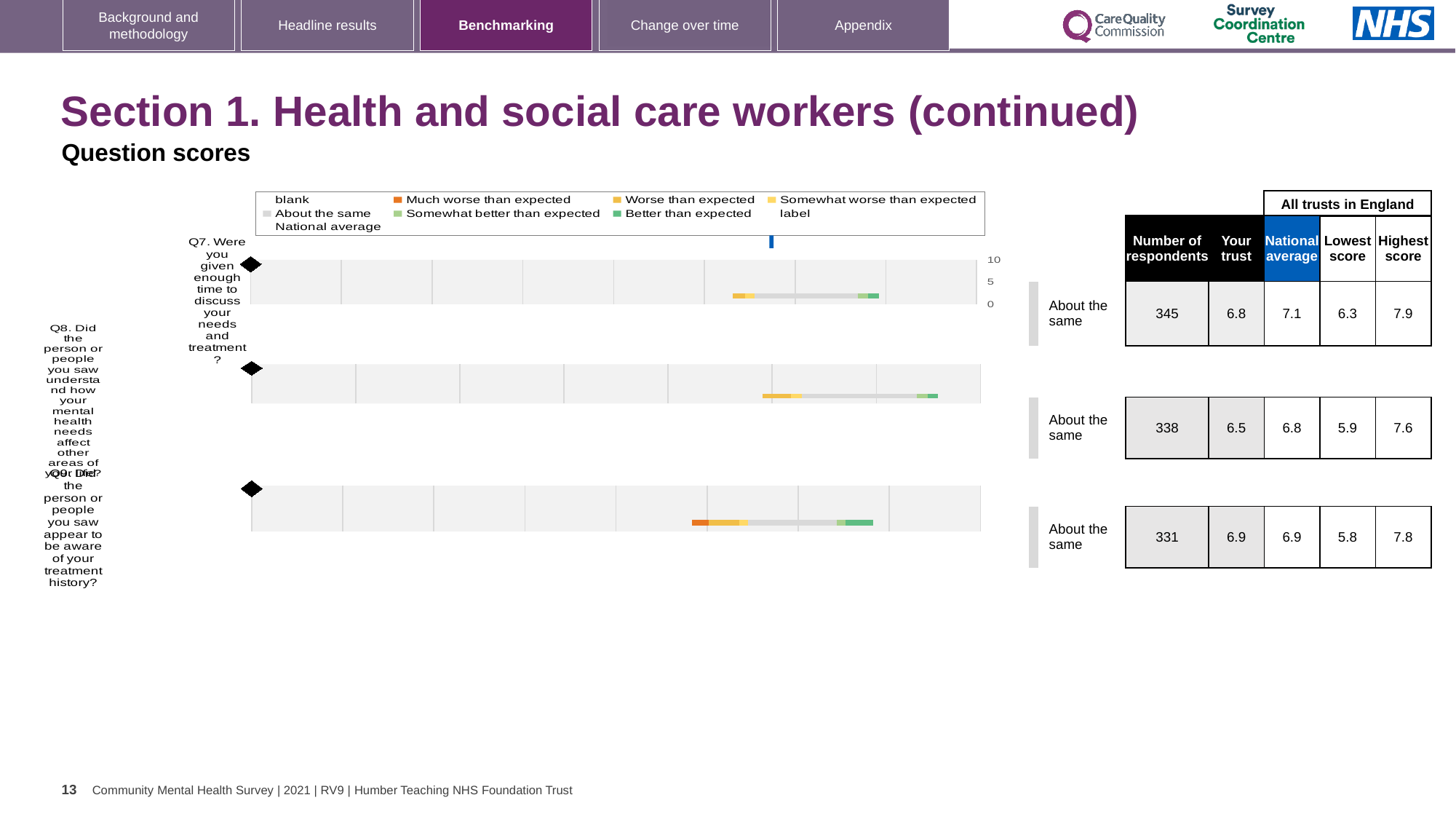
For Q9 (awareness of treatment history), what is the highest score among all trusts in England? 7.8 According to the legend, what does the blue marker on the charts represent? National average For Q7, what is the difference between the highest score (7.9) and the lowest score (6.3) across all trusts in England? 1.6 What is the maximum value shown on the score axis of the charts? 10 For Q7, which is higher: the 'Your trust' score or the national average? National average How many question charts (Q7, Q8, Q9) are shown on the slide? 3 For Q7 (time to discuss needs and treatment), what is the number of respondents shown in the table? 345 For Q8 (understanding how mental health needs affect other areas of life), what is the national average score? 6.8 For Q7, what is the 'Your trust' score shown in the table? 6.8 For Q8, what is the lowest score among all trusts in England? 5.9 Which question has the largest number of respondents? Q7 What kind of chart is used to show the question scores on this slide? bar chart